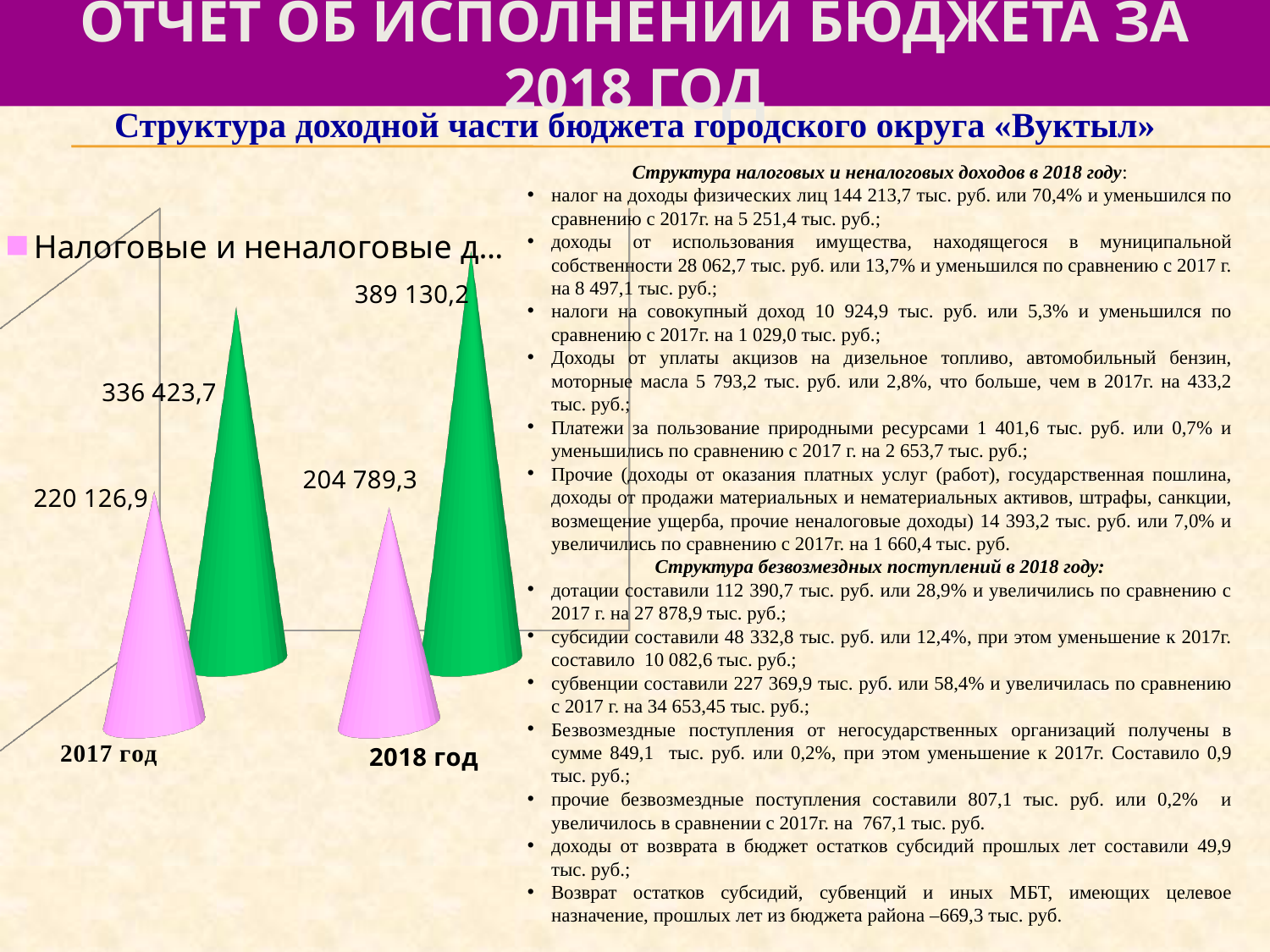
In the chart on the left, which year has the larger pink value, 2017 год or 2018 год? 2017 год What kind of chart is shown on the left of the slide? bar chart In the chart on the left, what is the value of the green cone for 2017 год? 336 423,7 In the chart on the left, does the green series rise or fall from 2017 год to 2018 год? rise In the chart on the left, what is the value of the green cone for 2018 год? 389 130,2 In the chart on the left, by how much did the pink series decrease from 2017 год to 2018 год? 15 337,6 In the chart on the left, which year has the larger green value, 2017 год or 2018 год? 2018 год In the chart on the left, what is the difference between the green and pink values for 2018 год? 184 340,9 In the chart on the left, what is the value of the pink cone for 2017 год? 220 126,9 How many year categories are shown on the x axis of the chart on the left? 2 In the chart on the left, what is the value of the pink cone for 2018 год? 204 789,3 In the chart on the left, by how much did the green series increase from 2017 год to 2018 год? 52 706,5